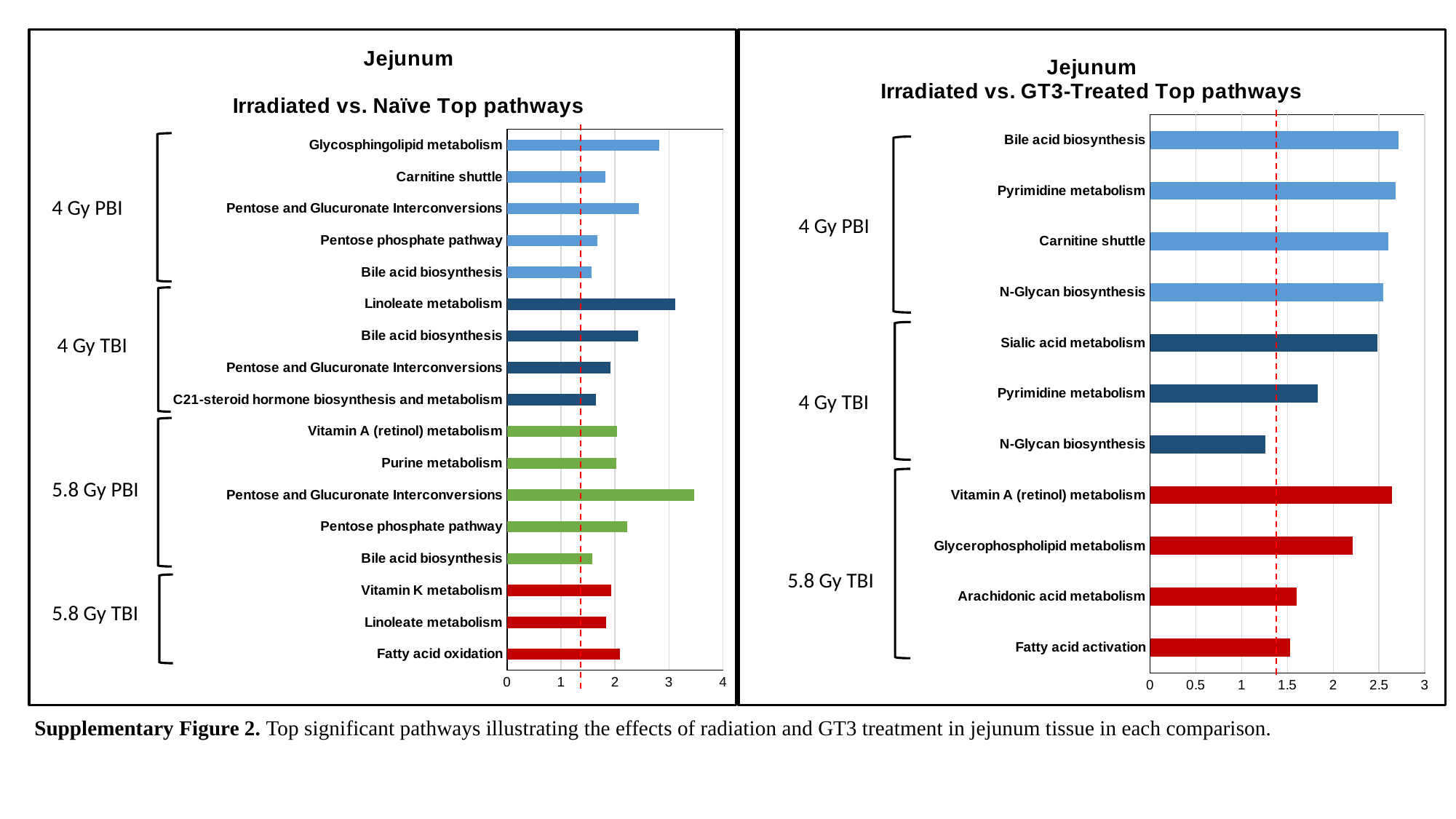
In the left chart (Irradiated vs. Naïve), is the value for Glycosphingolipid metabolism greater or less than 2? greater In the right chart (Irradiated vs. GT3-Treated), is the value for N-Glycan biosynthesis in the 4 Gy TBI group greater or less than 1.5? less In the right chart (Irradiated vs. GT3-Treated), how many pathway bars are plotted in total? 11 In the left chart (Irradiated vs. Naïve), how many pathways are listed under the 5.8 Gy PBI group? 5 In the left chart (Irradiated vs. Naïve), which is larger: Linoleate metabolism in the 4 Gy TBI group or Carnitine shuttle in the 4 Gy PBI group? Linoleate metabolism (4 Gy TBI) In the left chart (Irradiated vs. Naïve), which pathway has the longest bar? Pentose and Glucuronate Interconversions (5.8 Gy PBI) In the right chart (Irradiated vs. GT3-Treated), is the value for Glycerophospholipid metabolism greater or less than 2? greater In the right chart (Irradiated vs. GT3-Treated), which pathway has the shortest bar? N-Glycan biosynthesis (4 Gy TBI) In the left chart (Irradiated vs. Naïve), how many pathway bars are plotted in total? 17 What type of chart is the 'Irradiated vs. Naïve Top pathways' chart on the left? bar chart In the right chart (Irradiated vs. GT3-Treated), which is larger: Sialic acid metabolism or Arachidonic acid metabolism? Sialic acid metabolism